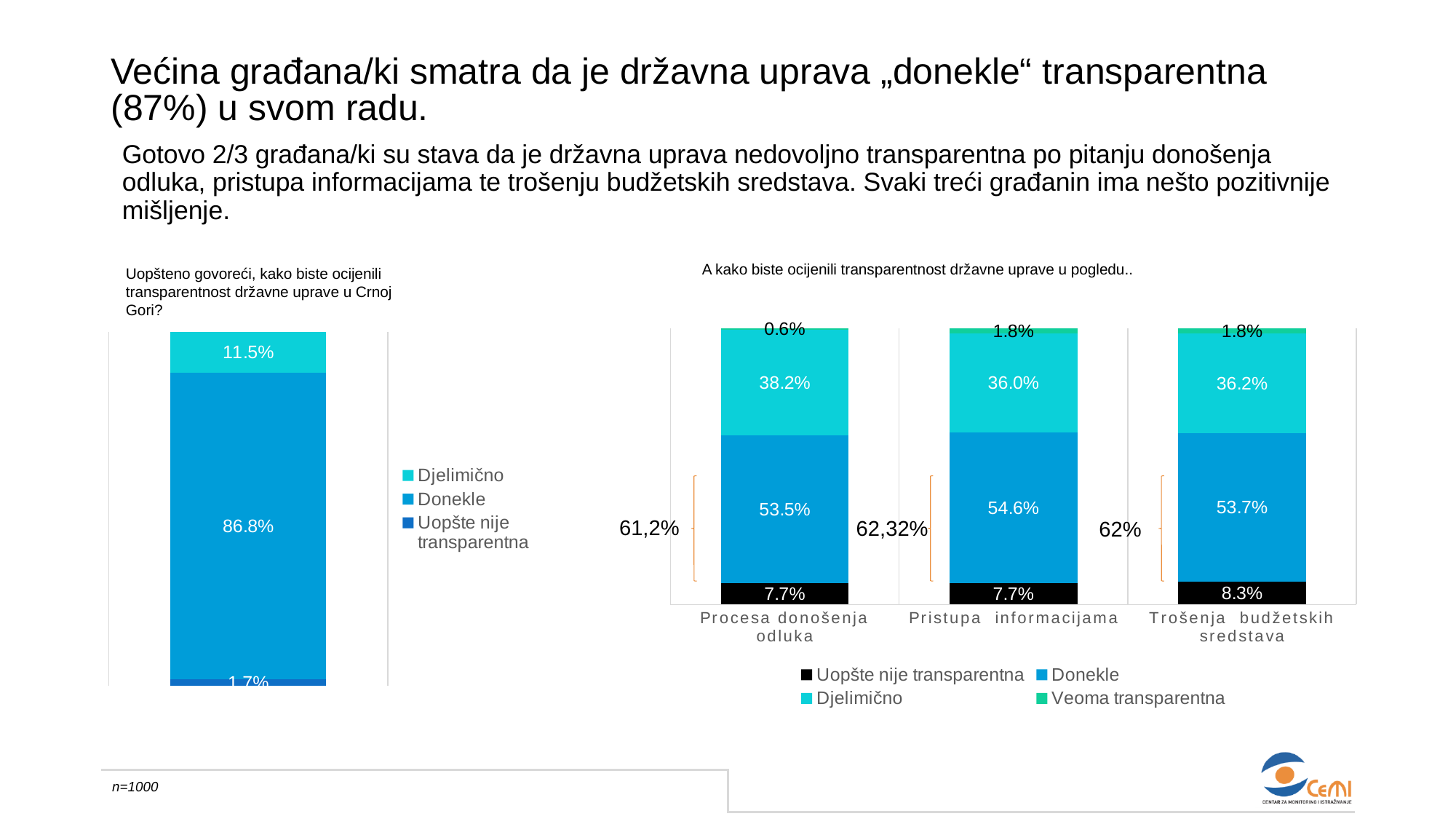
In the right chart, which category has the highest "Donekle" value? Pristupa informacijama In the left chart ("Uopšteno govoreći, kako biste ocijenili transparentnost državne uprave u Crnoj Gori?"), what is the value for "Donekle"? 86.8% In the right chart, what is the value of "Djelimično" for "Procesa donošenja odluka"? 38.2% In the right chart ("A kako biste ocijenili transparentnost državne uprave u pogledu.."), what is the value of "Donekle" for "Pristupa informacijama"? 54.6% In the left chart, what is the value for "Djelimično"? 11.5% What type of chart is the right chart? Stacked bar chart In the right chart, what is the value of "Uopšte nije transparentna" for "Trošenja budžetskih sredstava"? 8.3% In the right chart, which category has the lowest "Veoma transparentna" value? Procesa donošenja odluka In the right chart, is the "Uopšte nije transparentna" value larger for "Trošenja budžetskih sredstava" or for "Pristupa informacijama"? Trošenja budžetskih sredstava In the right chart, what is the difference between the "Djelimično" values for "Procesa donošenja odluka" and "Pristupa informacijama"? 2.2% How many categories are shown on the x axis of the right chart? 3 How many series does the legend of the right chart list? 4